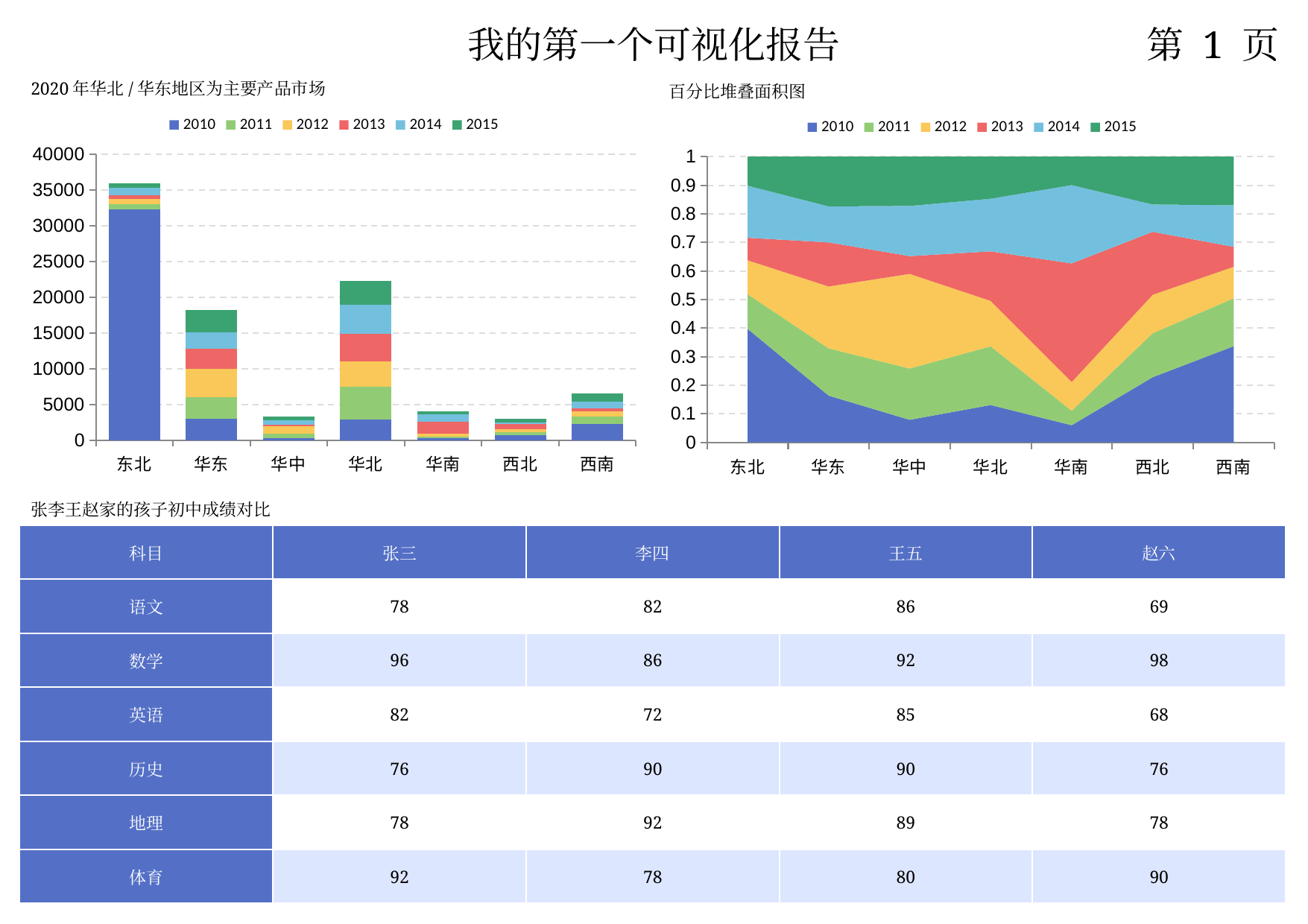
In the chart titled '2020 年华北 / 华东地区为主要产品市场', is the total stacked value for 华北 greater or less than 20000? greater In the chart titled '2020 年华北 / 华东地区为主要产品市场', is the total stacked value for 西南 greater or less than 10000? less In the chart titled '百分比堆叠面积图', is the share of 2010 at 东北 greater or less than 0.5? less What kind of chart is the chart titled '百分比堆叠面积图'? stacked area chart What kind of chart is the chart titled '2020 年华北 / 华东地区为主要产品市场'? stacked bar chart In the chart titled '2020 年华北 / 华东地区为主要产品市场', how many regions are shown on the x axis? 7 In the chart titled '2020 年华北 / 华东地区为主要产品市场', which has the taller stacked bar, 华东 or 华北? 华北 In the chart titled '2020 年华北 / 华东地区为主要产品市场', which region has the tallest stacked bar? 东北 In the chart titled '2020 年华北 / 华东地区为主要产品市场', how many series does the legend list? 6 In the chart titled '百分比堆叠面积图', how many series does the legend list? 6 In the chart titled '百分比堆叠面积图', which colour represents the 2015 series in the legend? dark green